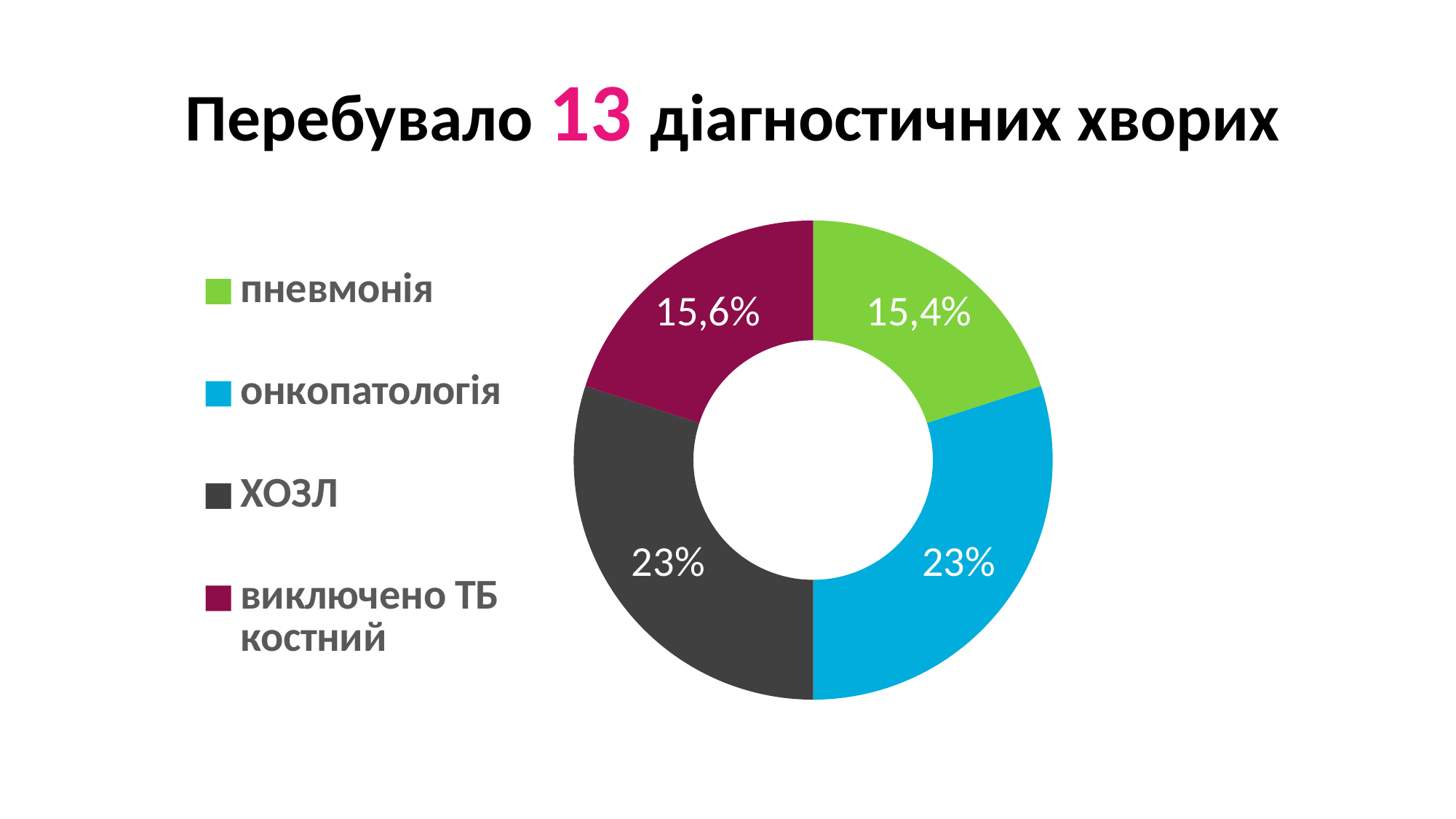
Which is larger, the share for онкопатологія or the share for пневмонія? онкопатологія What is the title of the slide? Перебувало 13 діагностичних хворих What percentage is shown for ХОЗЛ? 23% Which colour represents пневмонія in the chart? green What percentage is shown for онкопатологія? 23% What kind of chart is shown on the slide? doughnut chart Which is larger, the share for пневмонія or the share for виключено ТБ костний? виключено ТБ костний What percentage is shown for пневмонія? 15,4% What is the difference between the share for виключено ТБ костний and the share for пневмонія? 0,2% What is the difference between the share for онкопатологія and the share for пневмонія? 7,6% What percentage is shown for виключено ТБ костний? 15,6% How many categories does the chart show? 4